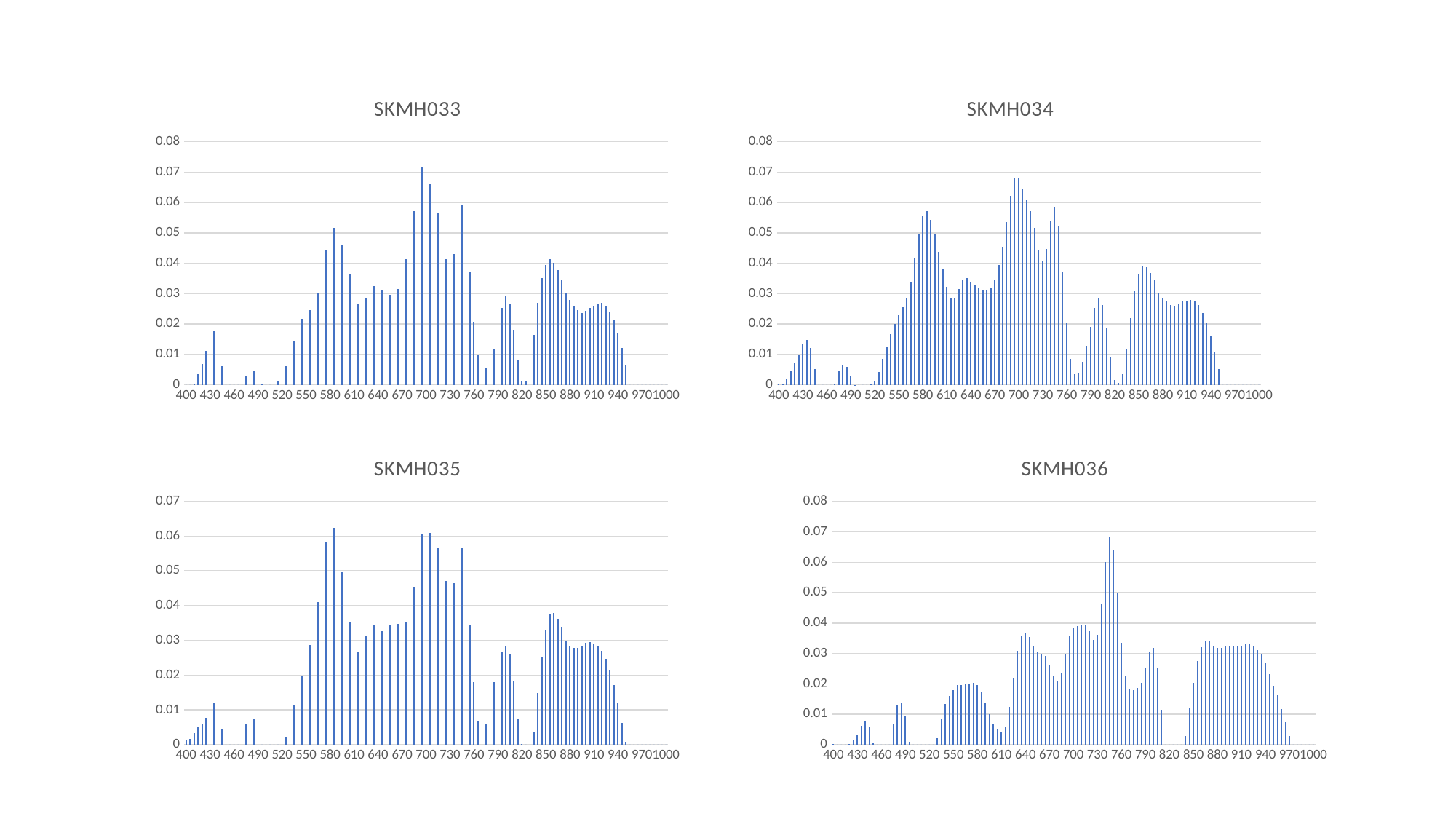
In the SKMH034 chart, is the tallest bar (near 700) greater or less than 0.06? greater In the SKMH033 chart, are the bars around 430 greater or less than 0.02? less What kind of chart is SKMH033? bar chart In the SKMH036 chart, are the bars around 880 greater or less than 0.03? greater What is the first value labelled on the horizontal axis of the SKMH033 chart? 400 How many charts are shown on the slide? 4 What is the highest value shown on the vertical axis of the SKMH035 chart? 0.07 What is the title of the chart in the bottom-right position? SKMH036